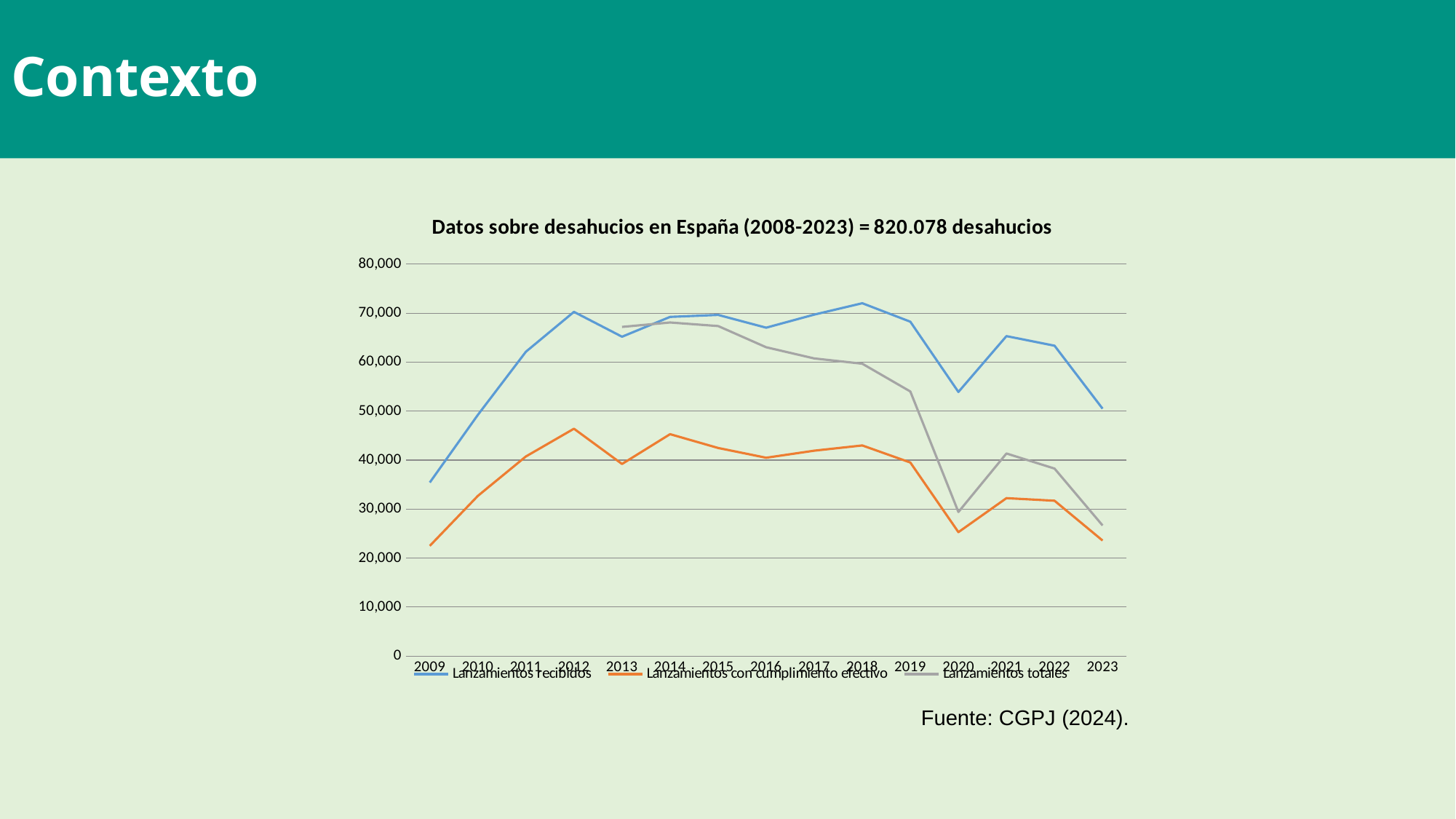
In which year does the 'Lanzamientos recibidos' series reach its highest value? 2018 What is the title of the chart? Datos sobre desahucios en España (2008-2023) = 820.078 desahucios How many years are shown on the x axis? 15 In 2023, which series has the larger value: 'Lanzamientos recibidos' or 'Lanzamientos con cumplimiento efectivo'? Lanzamientos recibidos Is the value for 'Lanzamientos totales' in 2013 greater or less than 60,000? greater What kind of chart is shown on the slide? Line chart How many series does the legend list? 3 Is the value for 'Lanzamientos recibidos' in 2018 greater or less than 70,000? greater In which year does the 'Lanzamientos recibidos' series have its lowest value? 2009 Is the value for 'Lanzamientos recibidos' in 2009 greater or less than 40,000? less Does the 'Lanzamientos recibidos' series rise or fall between 2009 and 2012? Rise